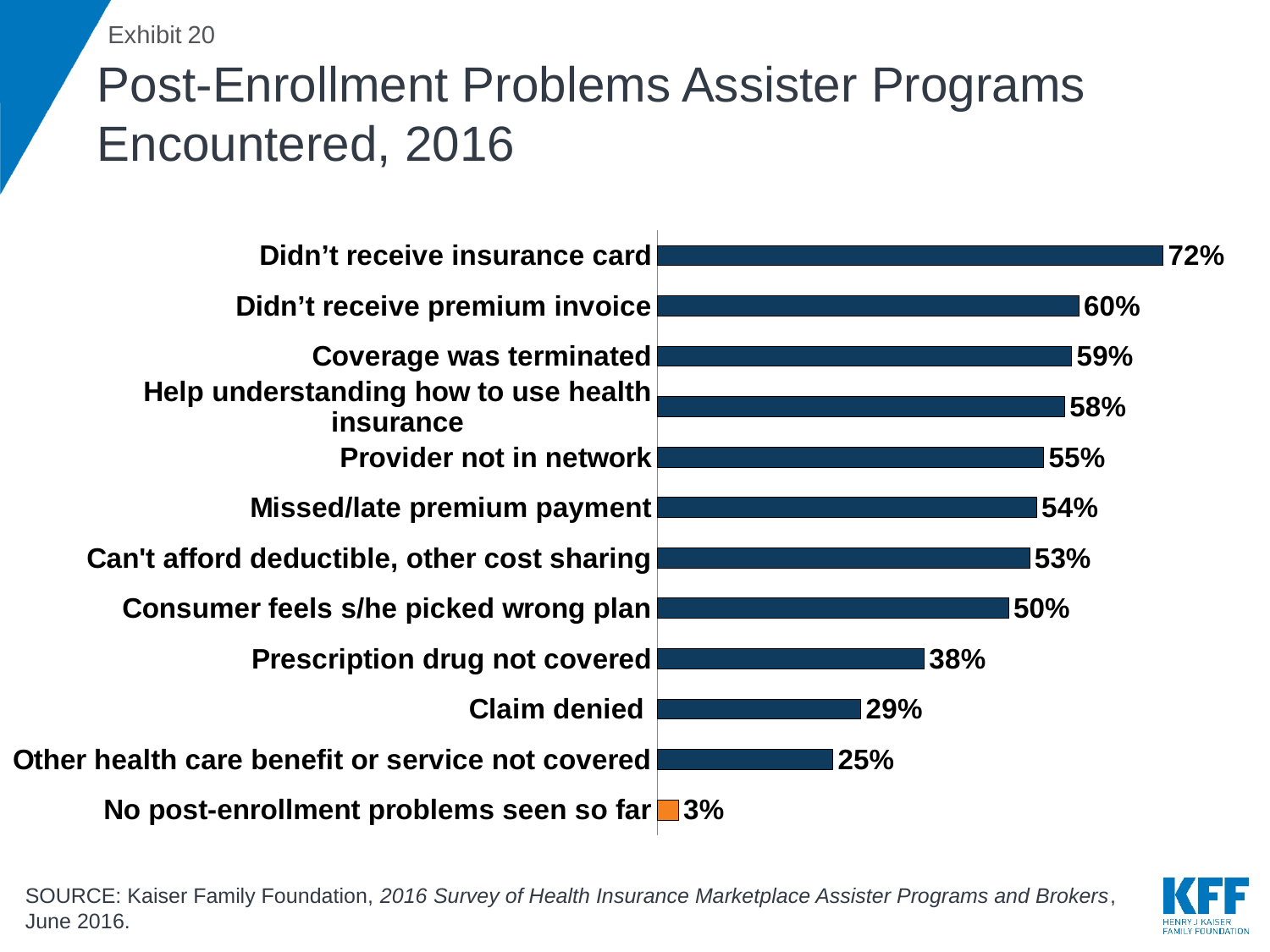
What is the difference between "Claim denied" and "Other health care benefit or service not covered"? 4% How many categories are shown in the chart? 12 What is the value for "Prescription drug not covered"? 38% Which bar is shown in a different colour (orange) from the others? No post-enrollment problems seen so far What kind of chart is shown on the slide? Bar chart Which category has the lowest value? No post-enrollment problems seen so far Which post-enrollment problem has the highest value? Didn't receive insurance card What is the value for "Coverage was terminated"? 59% Which is larger: "Provider not in network" or "Consumer feels s/he picked wrong plan"? Provider not in network What is the difference between "Didn't receive insurance card" and "Didn't receive premium invoice"? 12% What percentage of assister programs reported that consumers didn't receive an insurance card? 72% What is the value for "Claim denied"? 29%